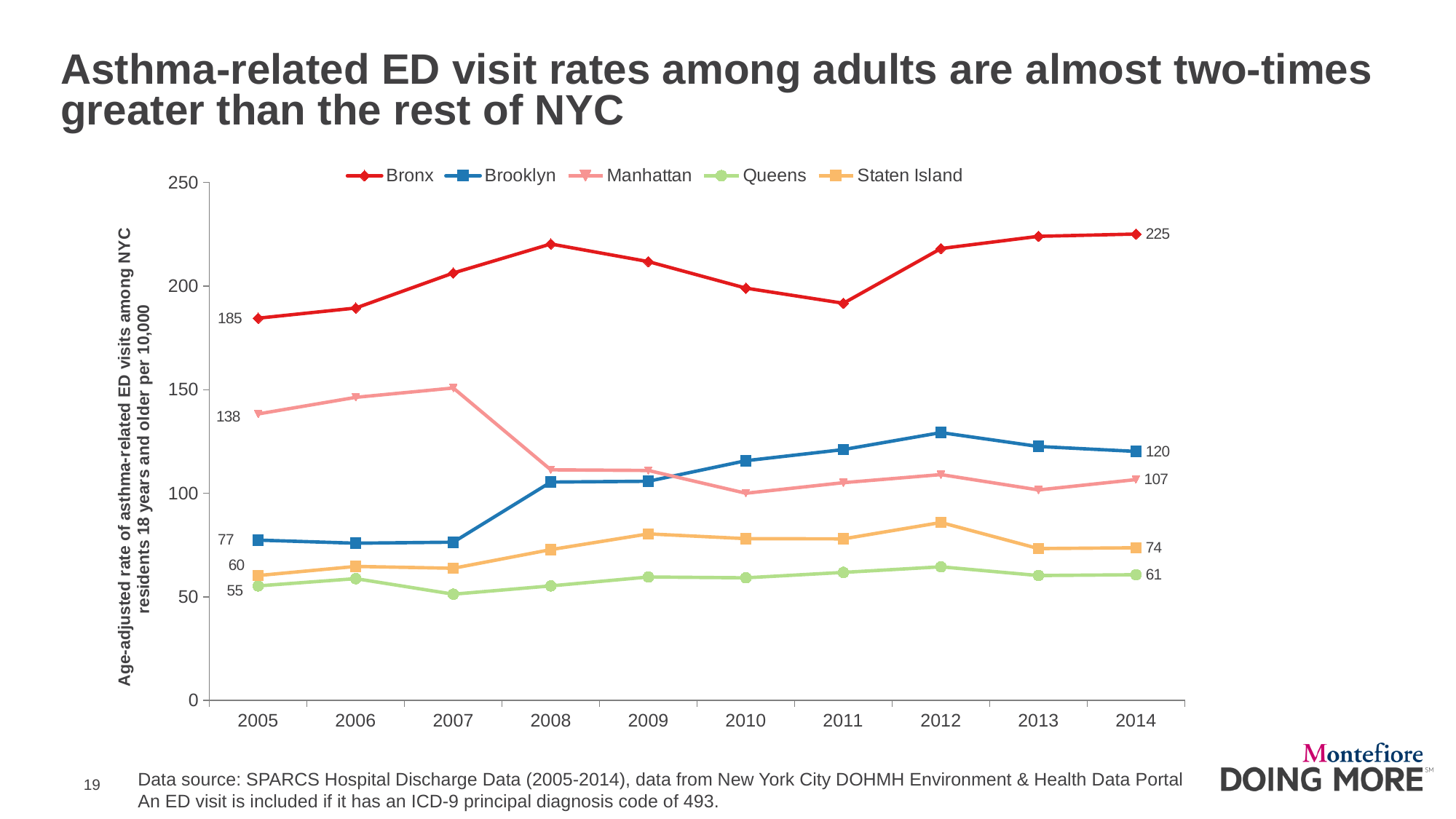
How many series does the legend list? 5 Which borough has the highest rate in 2014? Bronx In 2005, which is larger: the Brooklyn value or the Manhattan value? Manhattan Which borough has the lowest rate in 2005? Queens What is the difference between the Brooklyn and Manhattan values in 2014? 13 What kind of chart is shown on the slide? Line chart What is the Manhattan value in 2005? 138 Is the Bronx value in 2008 greater or less than 200? greater What is the Queens value in 2014? 61 What is the Bronx value in 2014? 225 By how much did the Bronx rate increase from 2005 to 2014? 40 What is the Staten Island value in 2005? 60